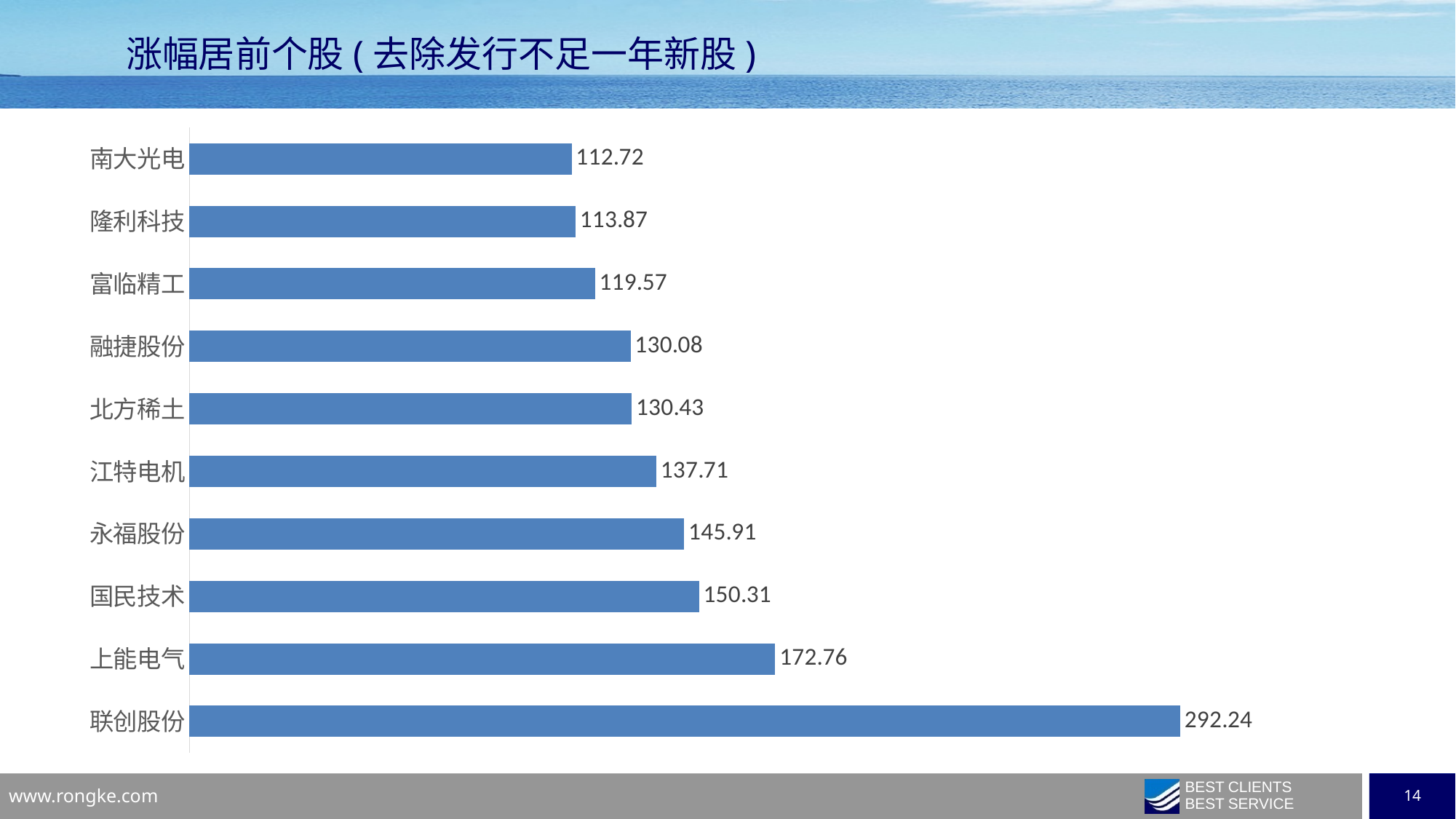
What is the value for 北方稀土? 130.43 What is the value for 永福股份? 145.91 What kind of chart is shown on the slide? Bar chart What is the difference between the values for 联创股份 and 上能电气? 119.48 What is the difference between the values for 国民技术 and 永福股份? 4.40 What is the value for 南大光电? 112.72 What is the title of the slide? 涨幅居前个股（去除发行不足一年新股） Which stock has the lowest value in the chart? 南大光电 Which is larger, the value for 上能电气 or the value for 国民技术? 上能电气 How many stocks are shown in the chart? 10 Which stock has the highest value in the chart? 联创股份 What is the value for 联创股份? 292.24